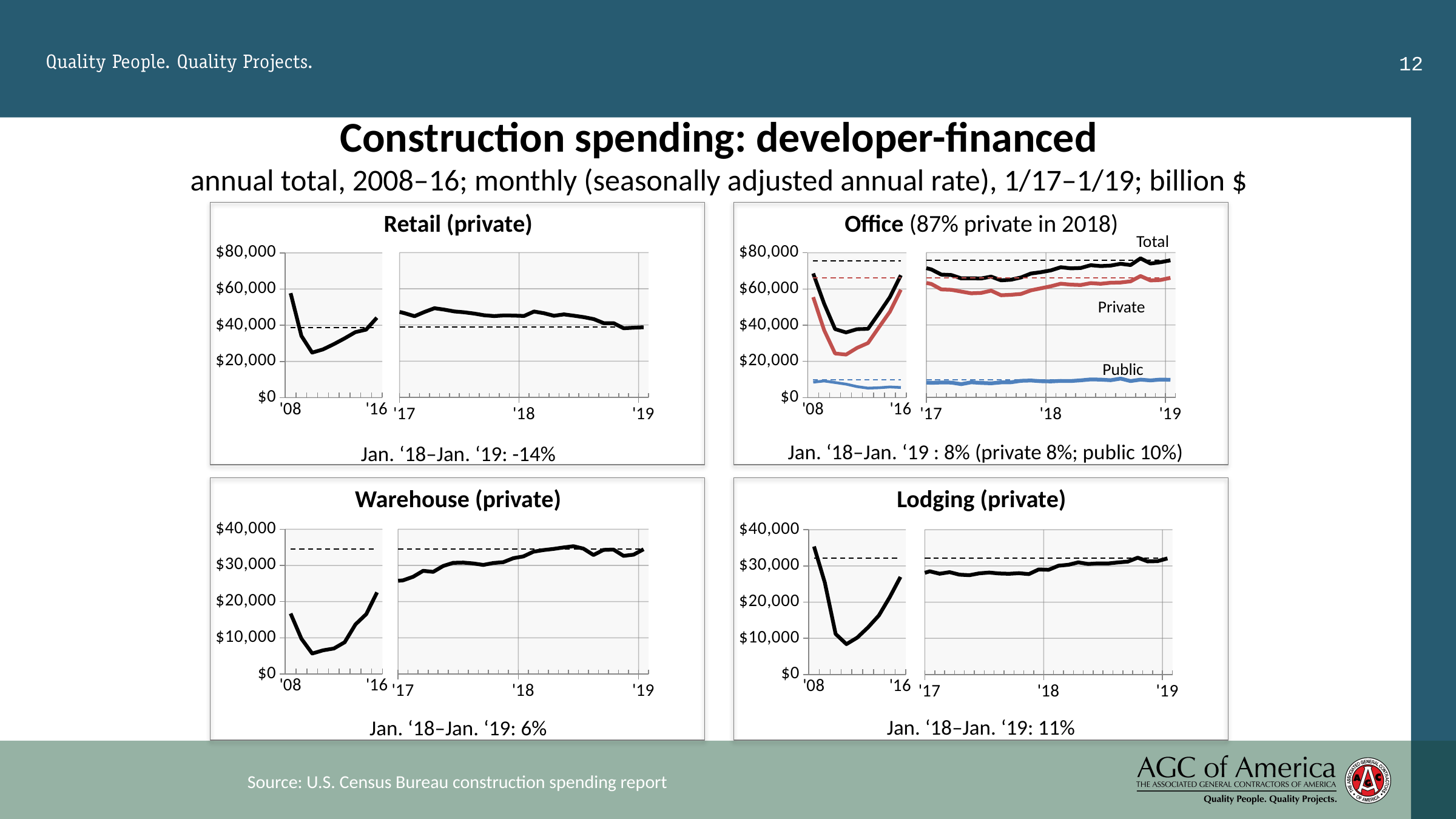
What percentage change from Jan. '18 to Jan. '19 is printed on the Retail (private) chart? -14% What kind of chart is the Retail (private) chart? line chart What percentage change from Jan. '18 to Jan. '19 is printed on the Lodging (private) chart? 11% In the Office chart, what are the three labelled series? Total, Private, Public In the Retail (private) chart, do the monthly values generally rise or fall from '17 to '19? fall According to the Office chart title, what share of office spending was private in 2018? 87% In the Retail (private) chart, is the value for 2008 greater or less than $40,000? greater How many charts are shown on the slide? 4 In the Office chart, how many series are labelled? 3 In the Lodging (private) chart, is the value for 2016 greater or less than $30,000? less What percentage change from Jan. '18 to Jan. '19 is printed on the Warehouse (private) chart? 6% In the Office chart, is the Public value for 2008 greater or less than $20,000? less